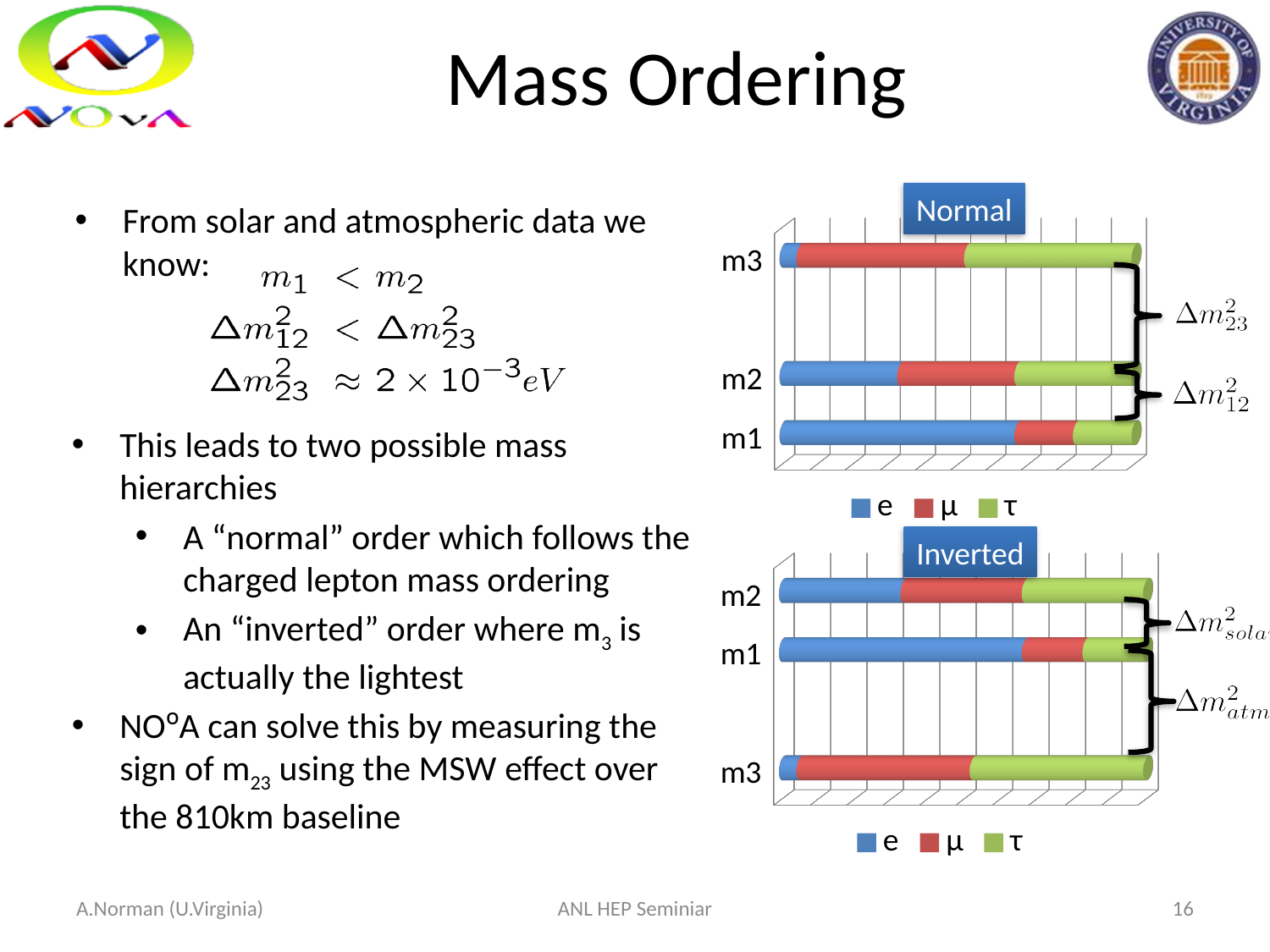
In the Inverted chart, which series has the largest segment in the m1 bar? e How many series does the legend of the Normal chart list? 3 In the Normal chart, which series has the largest segment in the m1 bar? e What kind of chart is the Inverted chart? stacked bar chart In the Normal chart, is the e segment of the m1 bar larger or smaller than the e segment of the m3 bar? larger How many series does the legend of the Inverted chart list? 3 In the Normal chart, which series has the smallest segment in the m3 bar? e How many bars (categories) are shown in the Inverted chart? 3 In the Inverted chart, which series has the smallest segment in the m3 bar? e How many bars (categories) are shown in the Normal chart? 3 What are the legend entries of the Inverted chart? e, μ, τ What kind of chart is the Normal chart? stacked bar chart